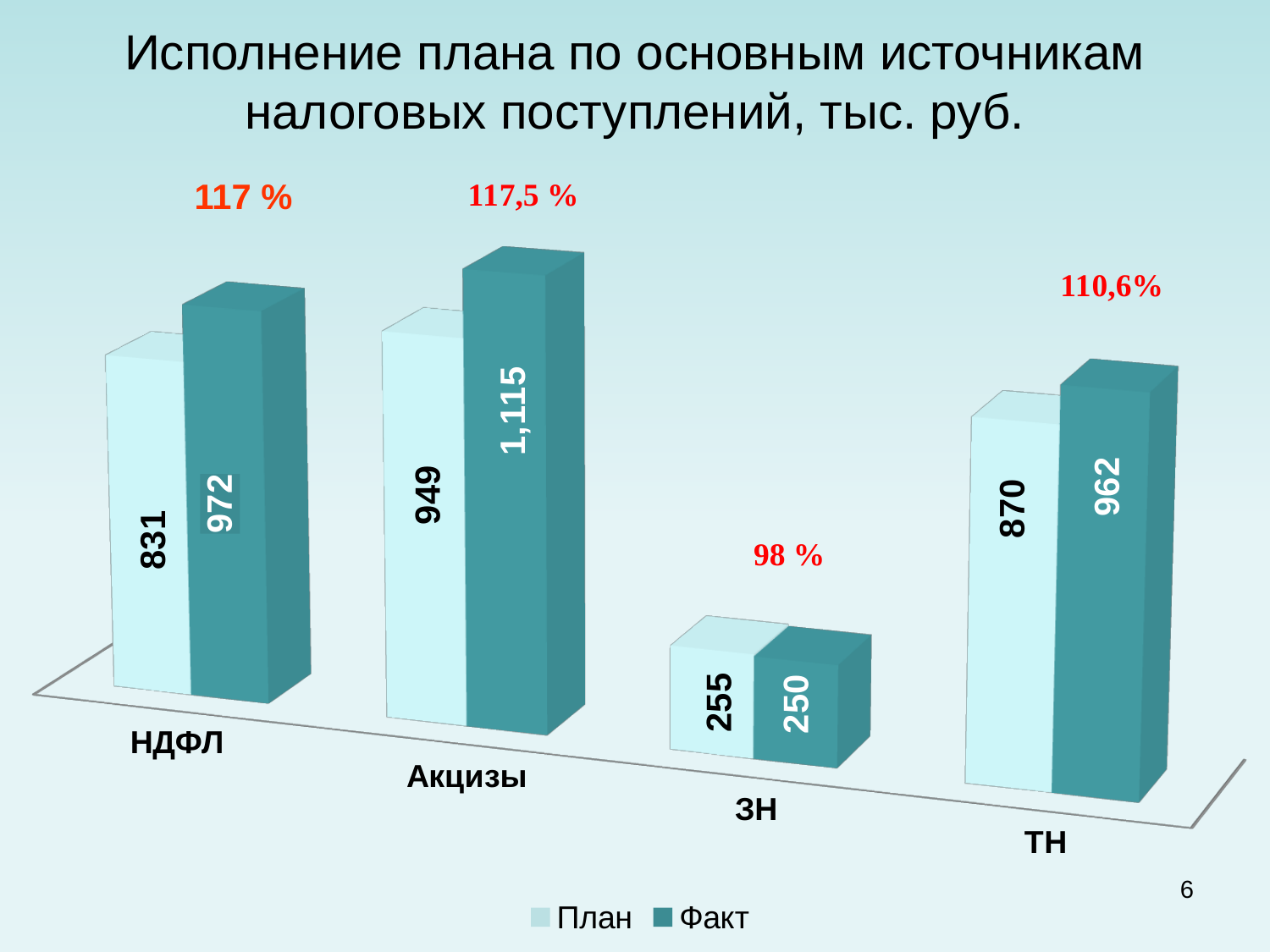
What is the Факт value for Акцизы? 1,115 Which category has the lowest План value? ЗН What is the План value for НДФЛ? 831 How many series does the legend list? 2 Which category has the highest Факт value? Акцизы What is the Факт value for ЗН? 250 Which is larger for ЗН, the План value or the Факт value? План What percentage of plan fulfilment is annotated above the ТН bars? 110,6% What kind of chart is shown on the slide? Bar chart What is the План value for ТН? 870 How many categories are shown on the x axis? 4 What is the difference between the Факт and План values for НДФЛ? 141